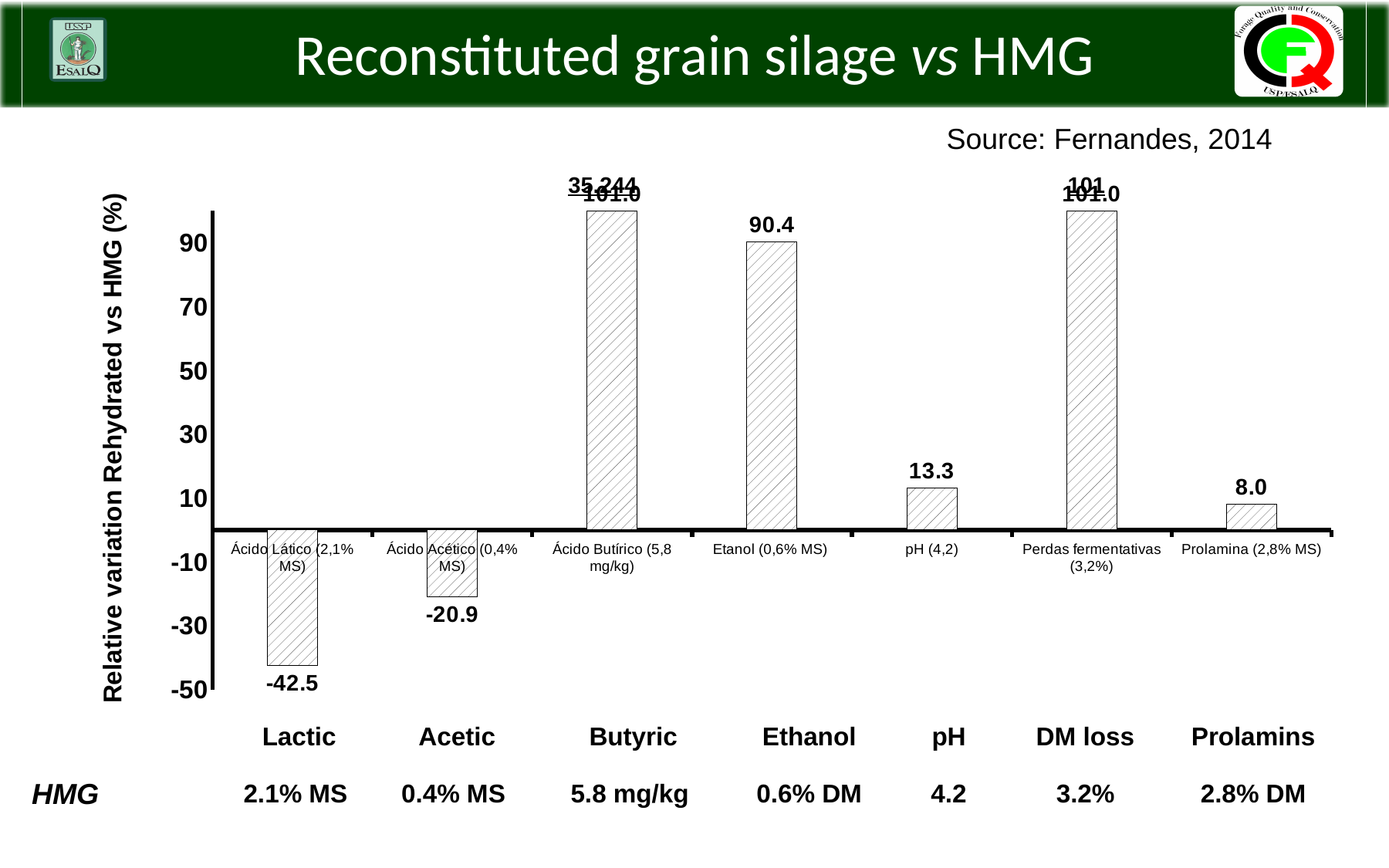
What is the relative variation value shown for Lactic? -42.5 Which category has the lowest relative variation value? Lactic What is the relative variation value shown for Prolamins? 8.0 What is the difference between the values for Ethanol and pH? 77.1 What is the relative variation value shown for pH? 13.3 Is the value for Butyric greater or less than 90? greater What is the title of the vertical axis? Relative variation Rehydrated vs HMG (%) What kind of chart is shown on the slide? bar chart How many categories are plotted in the chart? 7 Which has a larger value, Ethanol or pH? Ethanol What is the relative variation value shown for Acetic? -20.9 What is the relative variation value shown for Ethanol? 90.4